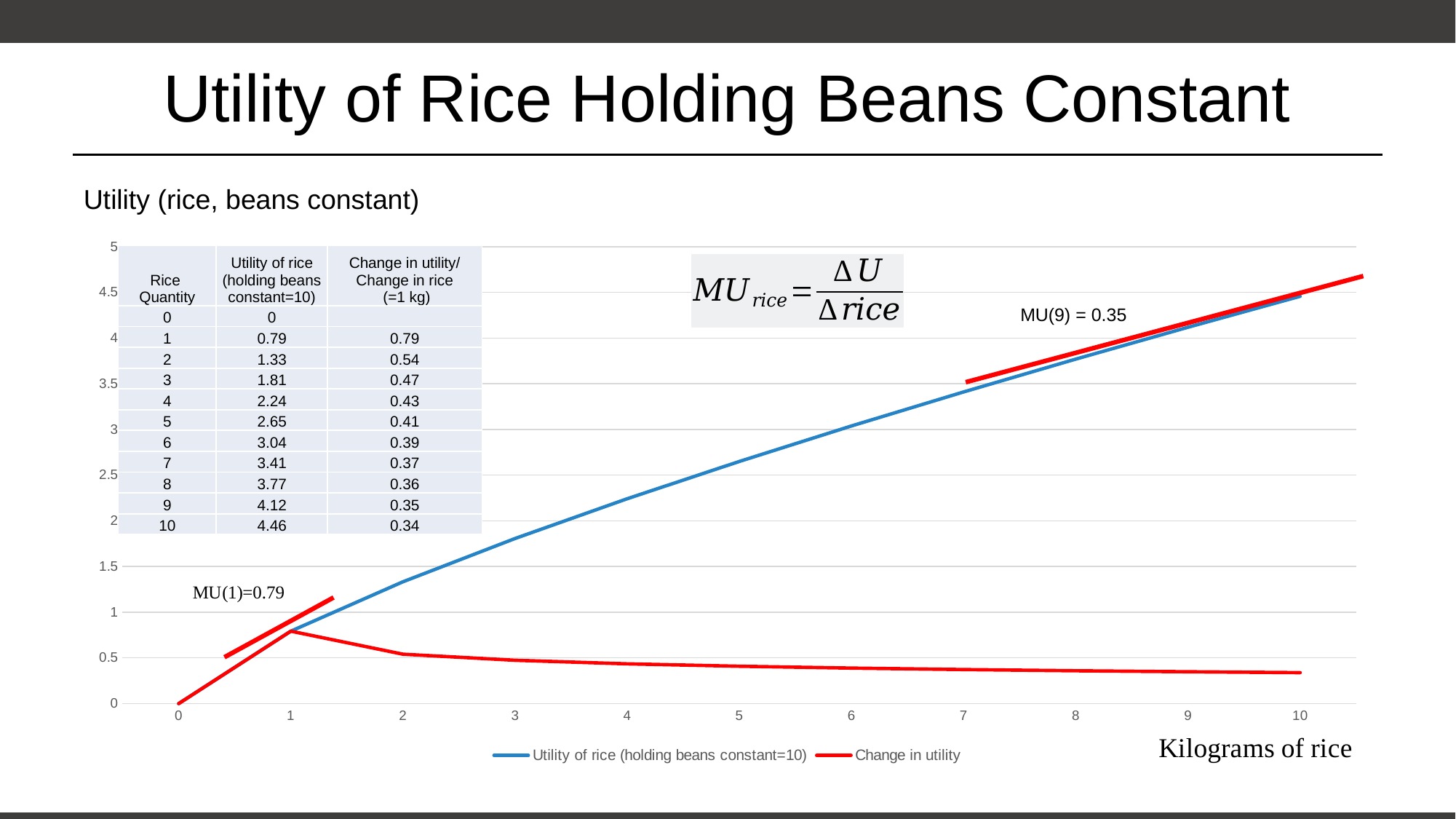
What is the difference in utility of rice between 9 kg and 8 kg of rice? 0.35 Does the utility of rice series rise or fall as kilograms of rice increase? rise At which rice quantity is the change in utility highest? 1 What is the change in utility at a rice quantity of 3 kg? 0.47 Is the utility of rice at 7 kg greater or less than 3? greater Which is larger: the change in utility at 2 kg or at 7 kg of rice? 2 kg What is the utility of rice at 10 kg of rice? 4.46 What kind of chart is shown on the slide? line chart How many series does the chart legend list? 2 What is the label on the x axis of the chart? Kilograms of rice What is the utility of rice at a rice quantity of 5 kg? 2.65